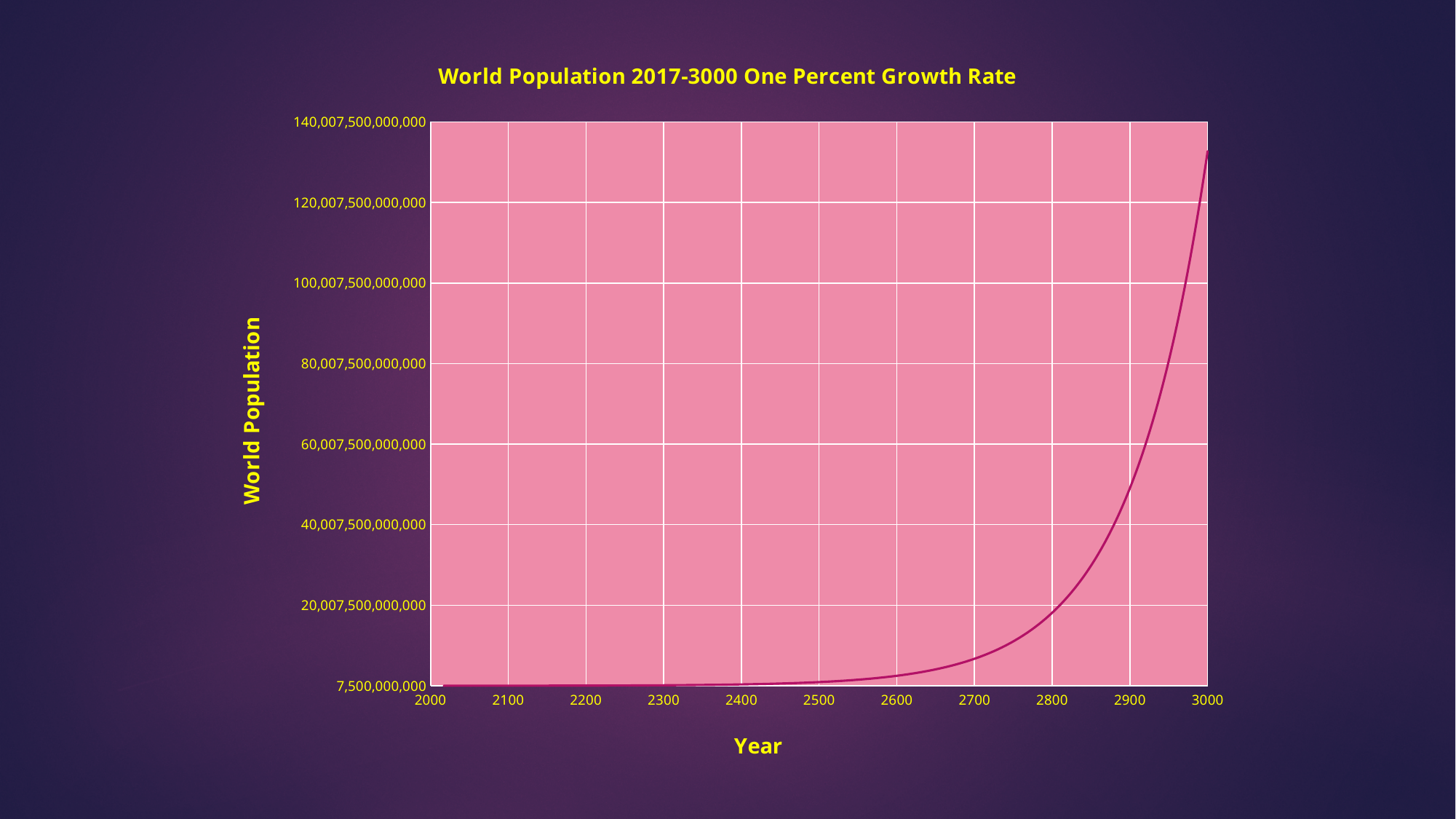
Is the value for the year 2900 greater or less than 60,007,500,000,000? less Is the value for the year 2800 greater or less than 20,007,500,000,000? less At which year shown on the x axis does the line reach its highest value? 3000 Which year has the higher value, 2800 or 3000? 3000 Is the value for the year 3000 greater or less than 120,007,500,000,000? greater Which year has the lower value, 2500 or 2900? 2500 What is the title of the chart? World Population 2017-3000 One Percent Growth Rate What kind of chart is shown on the slide? line chart Do the values rise or fall as the year increases along the x axis? rise What is the label of the x axis? Year